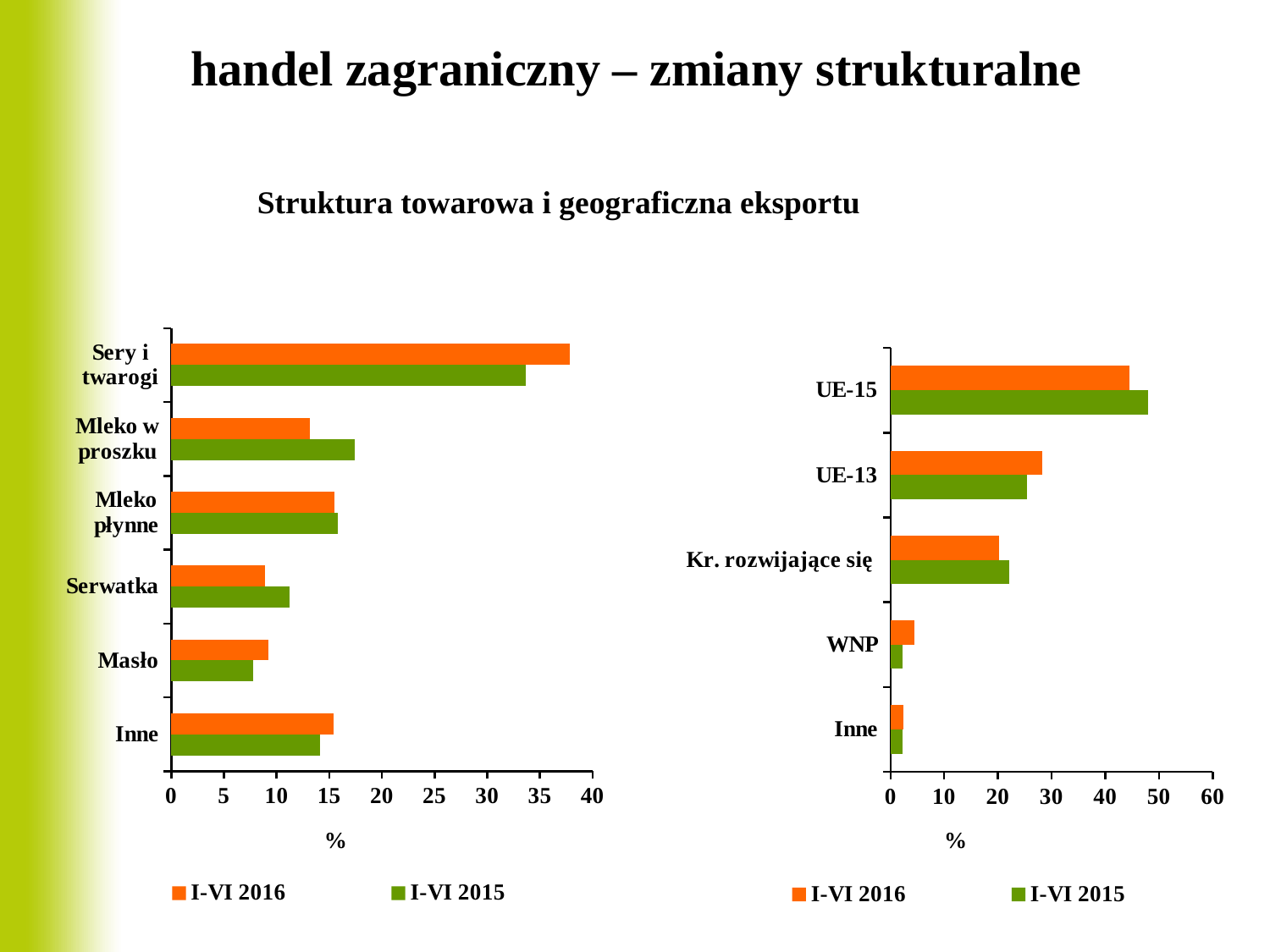
How many series does the legend of the right chart list? 2 In the right chart, which category has the lowest value for I-VI 2016? Inne In the left chart, which category has the highest value for I-VI 2016? Sery i twarogi What kind of chart is the left chart on the slide? bar chart In the left chart, is the I-VI 2016 value for Sery i twarogi greater or less than 35? greater In the right chart, which category has the highest value for I-VI 2015? UE-15 In the right chart, for UE-15, which series has the larger value, I-VI 2016 or I-VI 2015? I-VI 2015 In the left chart, for Mleko w proszku, which series has the larger value, I-VI 2016 or I-VI 2015? I-VI 2015 How many categories does the right chart show? 5 How many categories does the left chart show? 6 In the right chart, is the I-VI 2016 value for UE-13 greater or less than 30? less In the left chart, is the I-VI 2015 value for Mleko w proszku greater or less than 15? greater